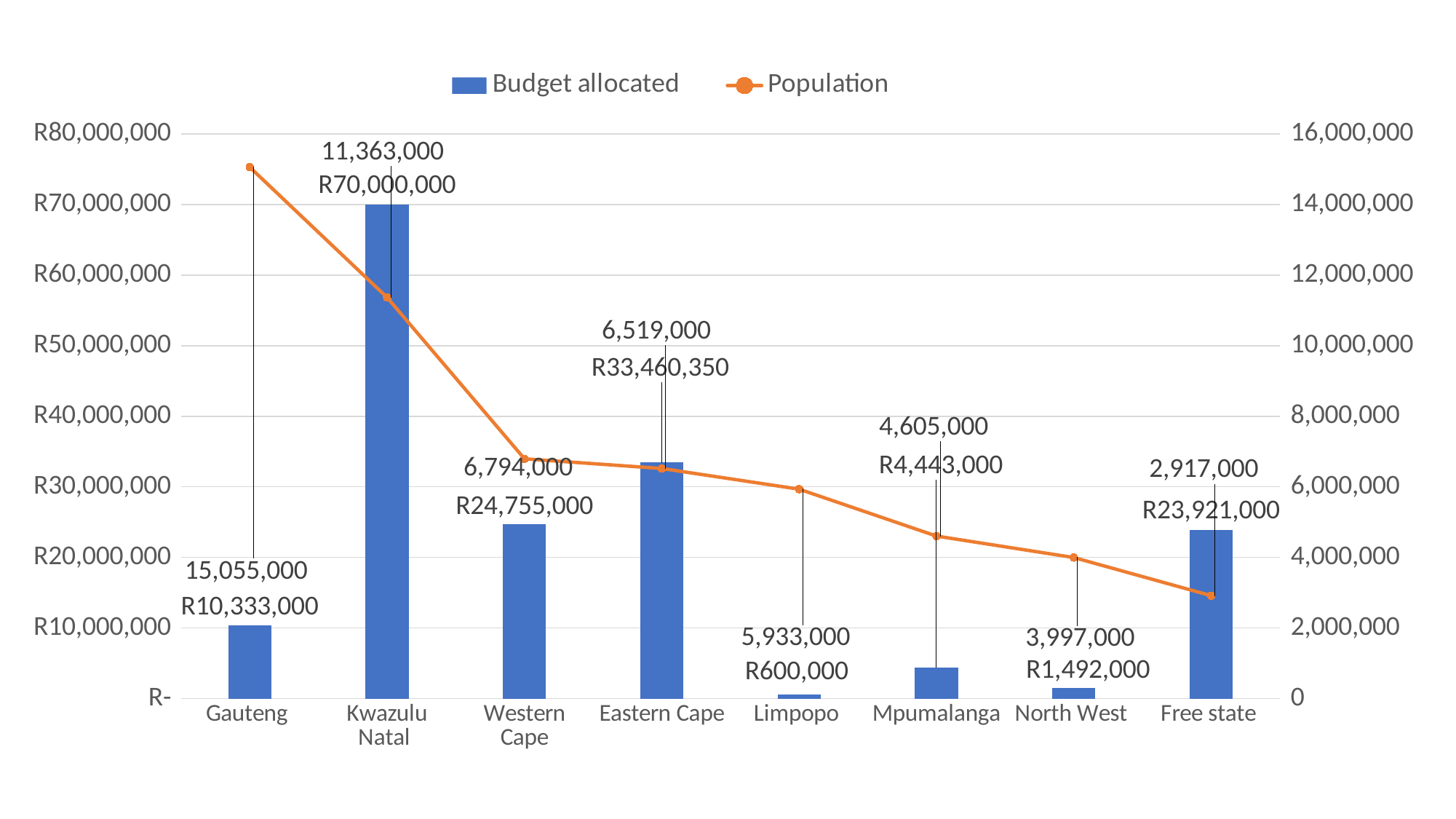
What is the difference between the budget allocated for Kwazulu Natal and Eastern Cape? R36,539,650 What is the population of Gauteng? 15,055,000 Which province has the lowest budget allocated? Limpopo Does the population line rise or fall from Gauteng to Free state? Fall What is the budget allocated for Kwazulu Natal? R70,000,000 Which province has the highest budget allocated? Kwazulu Natal Which province has the lowest population? Free state How many provinces are shown on the x axis? 8 What is the budget allocated for Eastern Cape? R33,460,350 How many series does the legend list? 2 Which has a larger budget allocated, Western Cape or Free state? Western Cape What is the population of North West? 3,997,000